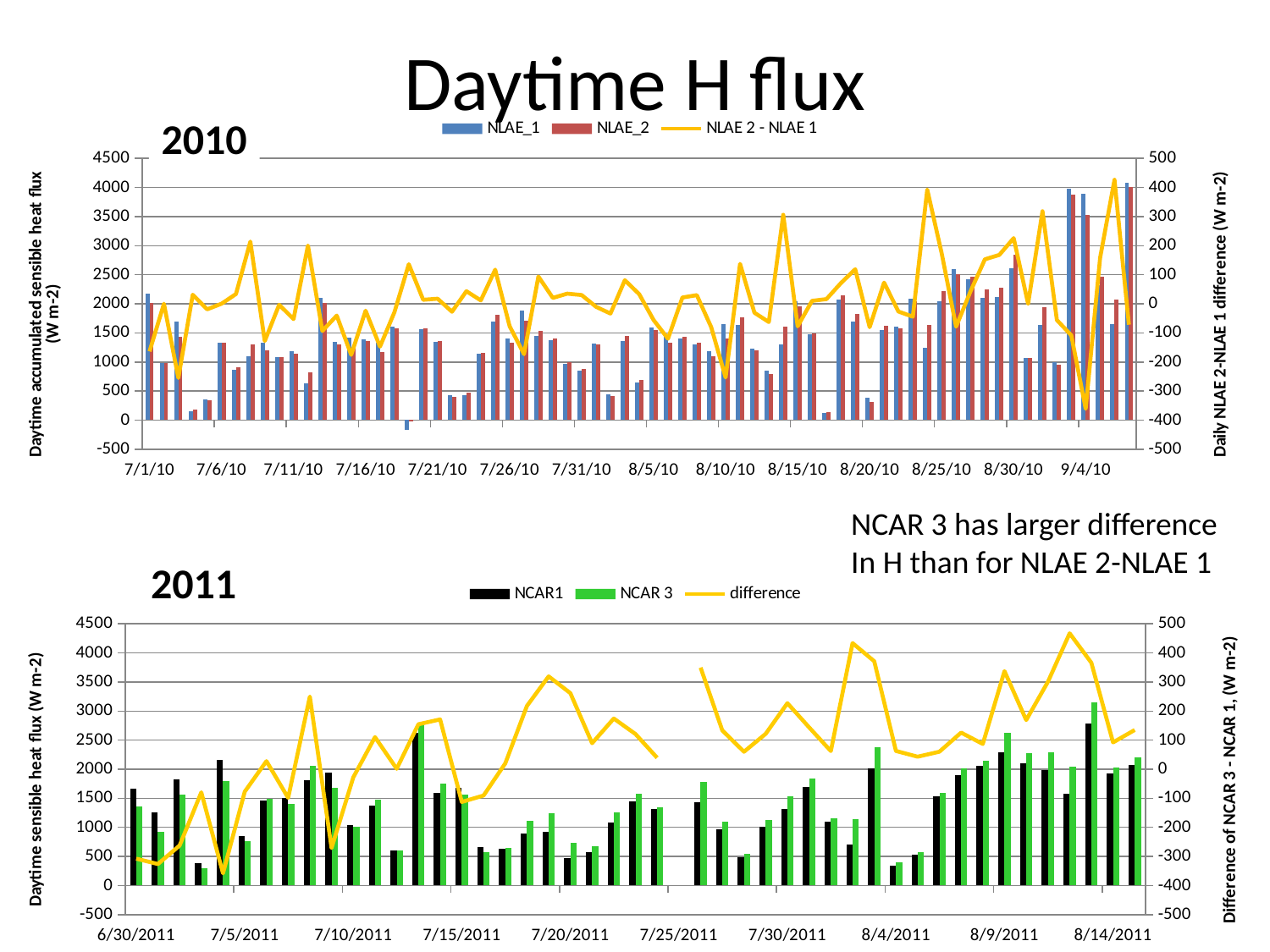
In the 2010 chart, is the tallest NLAE_1 bar greater or less than 3500? greater In the 2011 chart, on 6/30/2011 which is larger, NCAR1 or NCAR 3? NCAR1 In the 2011 chart, is the NCAR1 value on 6/30/2011 greater or less than 1000? greater In the 2010 chart, which series is plotted as a line rather than bars? NLAE 2 - NLAE 1 In the 2010 chart, is the lowest point of the NLAE 2 - NLAE 1 line greater or less than -300 on the right axis? less In the 2011 chart, what colour are the NCAR 3 bars? Green How many series does the legend of the 2011 chart list? 3 What kind of chart is the 2010 chart? Bar chart with a line How many series does the legend of the 2010 chart list? 3 What kind of chart is the 2011 chart? Bar chart with a line